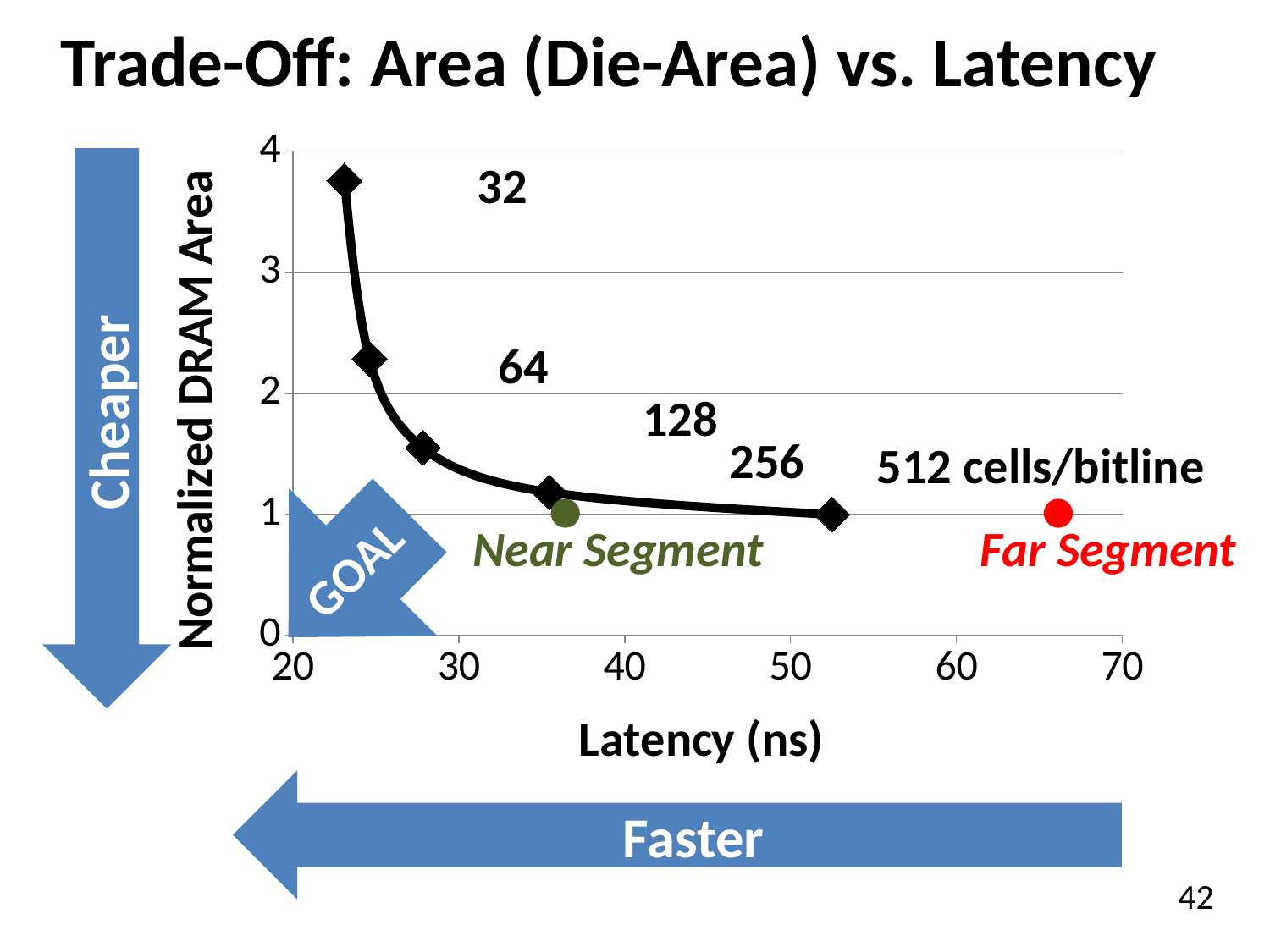
Is the normalized DRAM area for 32 cells/bitline greater or less than 3? greater Which cells/bitline configuration has the lowest latency? 32 As latency increases along the x axis, does the normalized DRAM area rise or fall? fall What is the label of the x axis? Latency (ns) How many cells/bitline data points are plotted on the black curve? 5 Which has the larger normalized DRAM area, 64 cells/bitline or 128 cells/bitline? 64 cells/bitline Is the normalized DRAM area for 128 cells/bitline greater or less than 2? less What kind of chart is shown on the slide? line chart Is the normalized DRAM area for 64 cells/bitline greater or less than 2? greater Which cells/bitline configuration has the highest normalized DRAM area? 32 Which cells/bitline configuration has the highest latency? 512